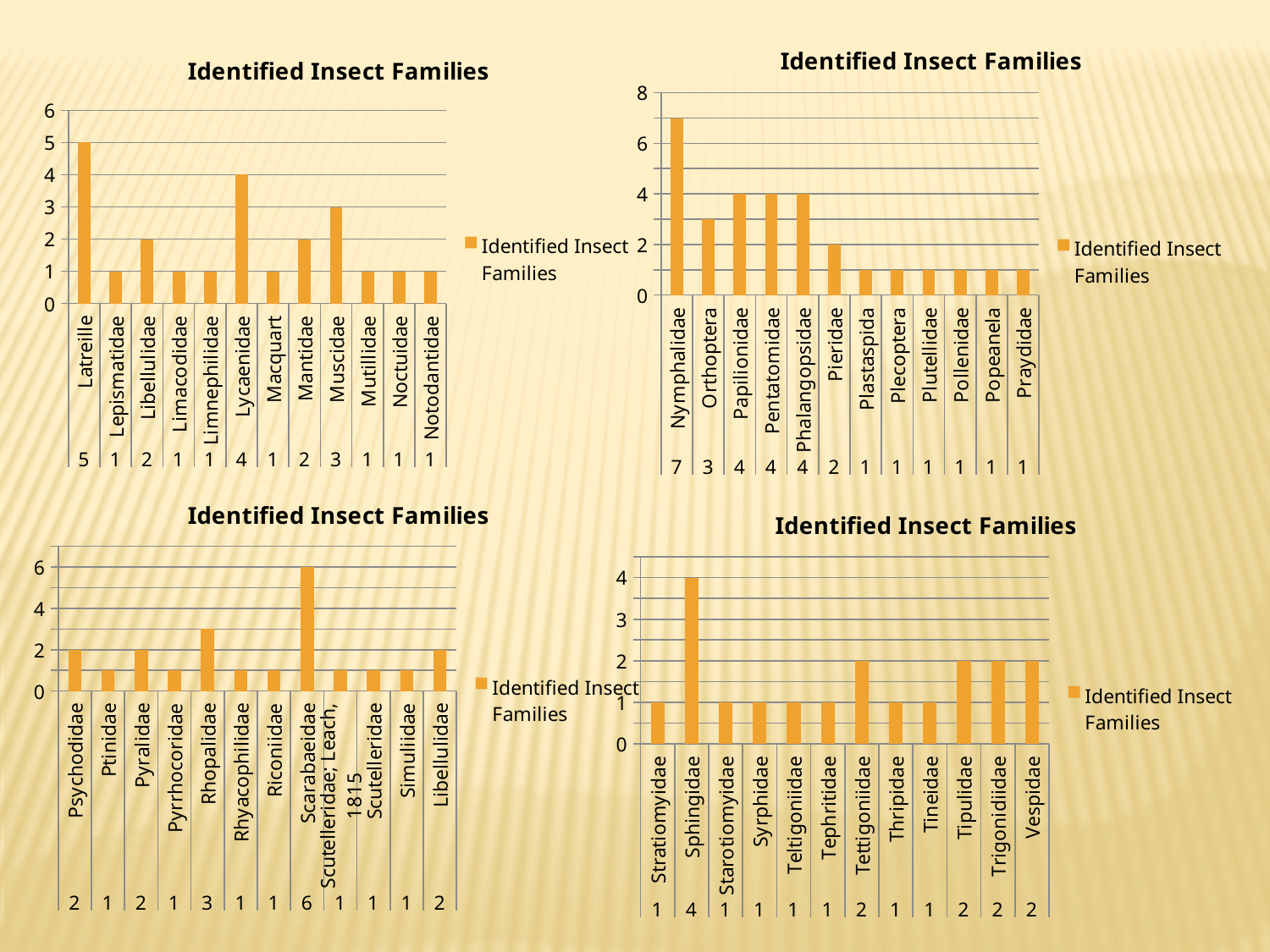
In the bottom-left chart, which category has the highest value? Scarabaeidae In the top-left chart, which category has the highest value? Latreille In the top-left chart, what is the difference between the values for Lycaenidae and Muscidae? 1 In the bottom-left chart, what is the value for Rhopalidae? 3 In the top-left chart, what is the value for Latreille? 5 In the bottom-right chart, what is the value for Tipulidae? 2 How many series does the legend of the top-left chart list? 1 In the bottom-right chart, which category has the highest value? Sphingidae In the top-right chart, what is the value for Nymphalidae? 7 In the top-right chart, how many categories are shown on the x axis? 12 What kind of chart is the bottom-right chart? Bar chart In the top-right chart, which is larger, the value for Orthoptera or the value for Pieridae? Orthoptera